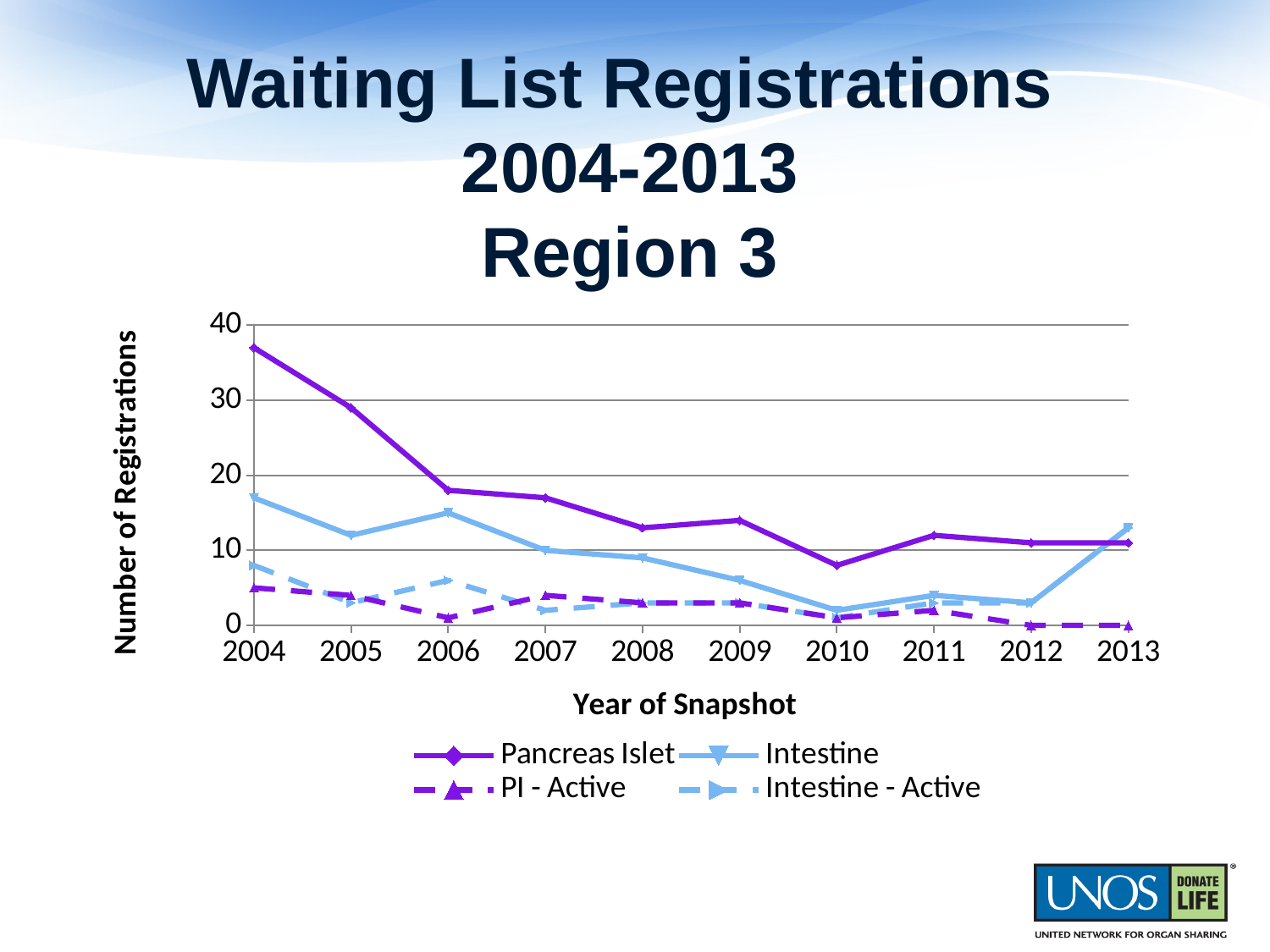
What kind of chart is shown on the slide? line chart In which year is the Pancreas Islet series at its lowest? 2010 Is the value for Intestine in 2004 greater or less than 10? greater In which year is the Intestine series at its highest? 2004 In 2004, which series has the larger value, Pancreas Islet or Intestine? Pancreas Islet How many series does the legend list? 4 Is the value for Pancreas Islet in 2006 greater or less than 20? less Is the value for Pancreas Islet in 2004 greater or less than 30? greater Does the Pancreas Islet series generally rise or fall from 2004 to 2013? fall What is the title of the vertical axis? Number of Registrations How many years are plotted along the x axis? 10 In which year is the Pancreas Islet series at its highest? 2004